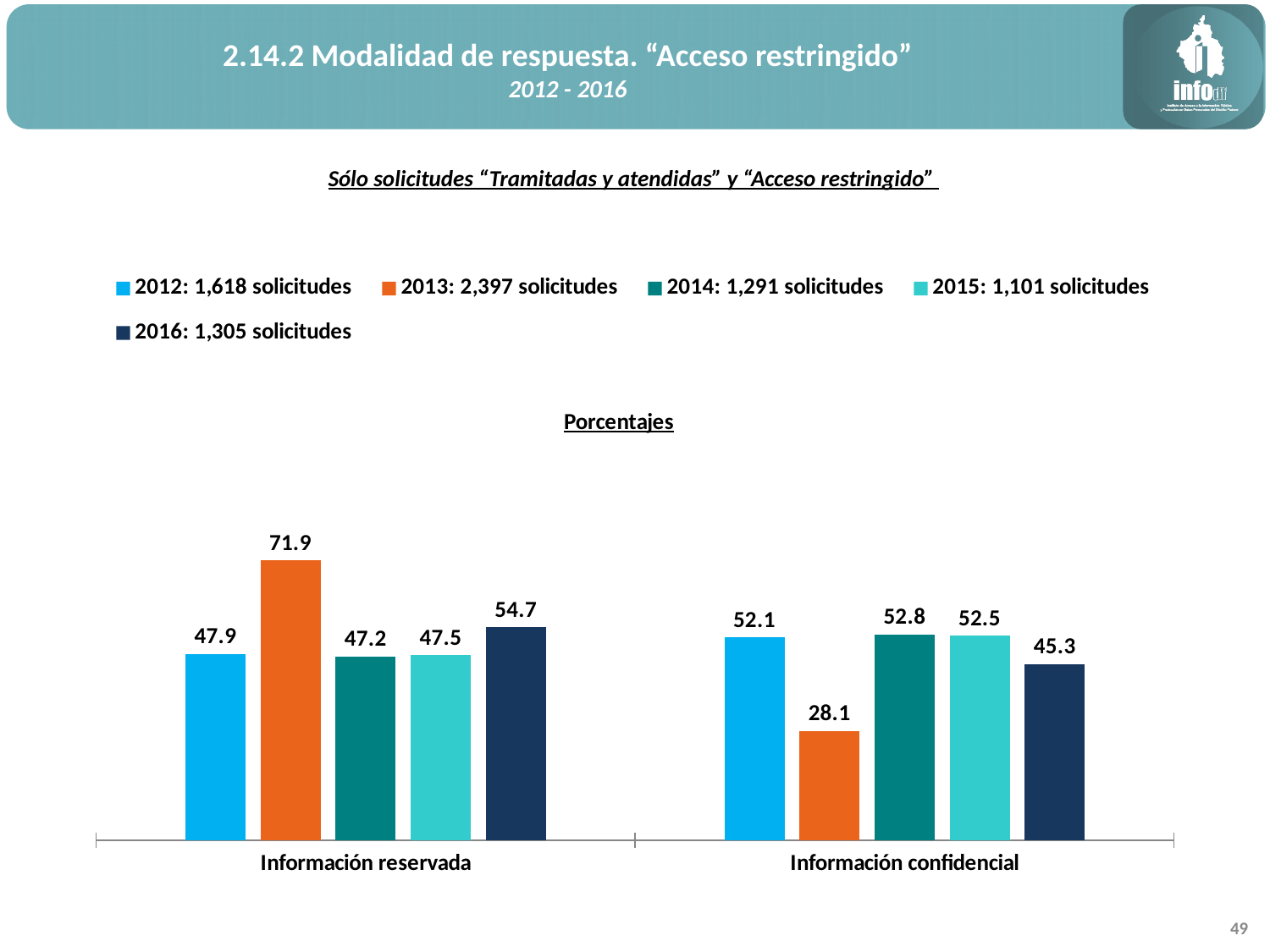
How many categories are shown on the x axis? 2 What is the difference between the 2013 values for Información reservada and Información confidencial? 43.8 What is the value for 2012 in the Información confidencial category? 52.1 How many series does the legend list? 5 Which year has the lowest value in the Información confidencial category? 2013 What is the value for 2013 in the Información reservada category? 71.9 What kind of chart is shown on the slide? Bar chart Which is larger: the 2016 value for Información reservada or the 2016 value for Información confidencial? Información reservada According to the legend, how many solicitudes were there in 2013? 2,397 What is the difference between the 2014 and 2015 values in the Información confidencial category? 0.3 What is the value for 2016 in the Información confidencial category? 45.3 Which year has the highest value in the Información reservada category? 2013